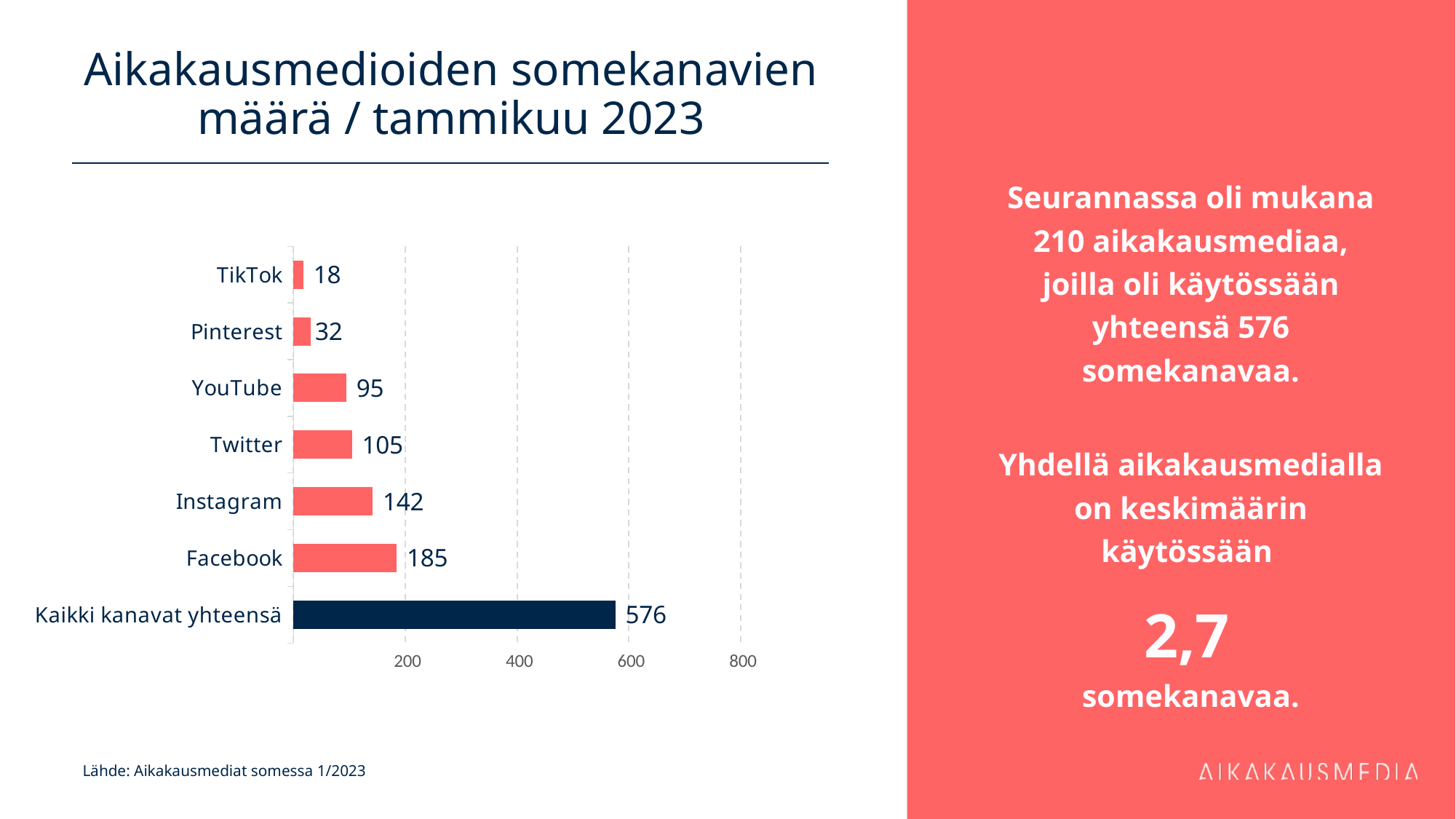
Which individual channel (excluding the total bar) has the highest value? Facebook How many categories are shown in the chart? 7 What is the value for Facebook? 185 What is the difference between the values for Facebook and Instagram? 43 What is the value for Instagram? 142 Which category has the lowest value? TikTok What is the value for TikTok? 18 What is the value for Kaikki kanavat yhteensä? 576 What is the title of the chart? Aikakausmedioiden somekanavien määrä / tammikuu 2023 What kind of chart is shown on the slide? Bar chart What is the difference between the values for Twitter and YouTube? 10 Which is larger, the value for Pinterest or the value for YouTube? YouTube